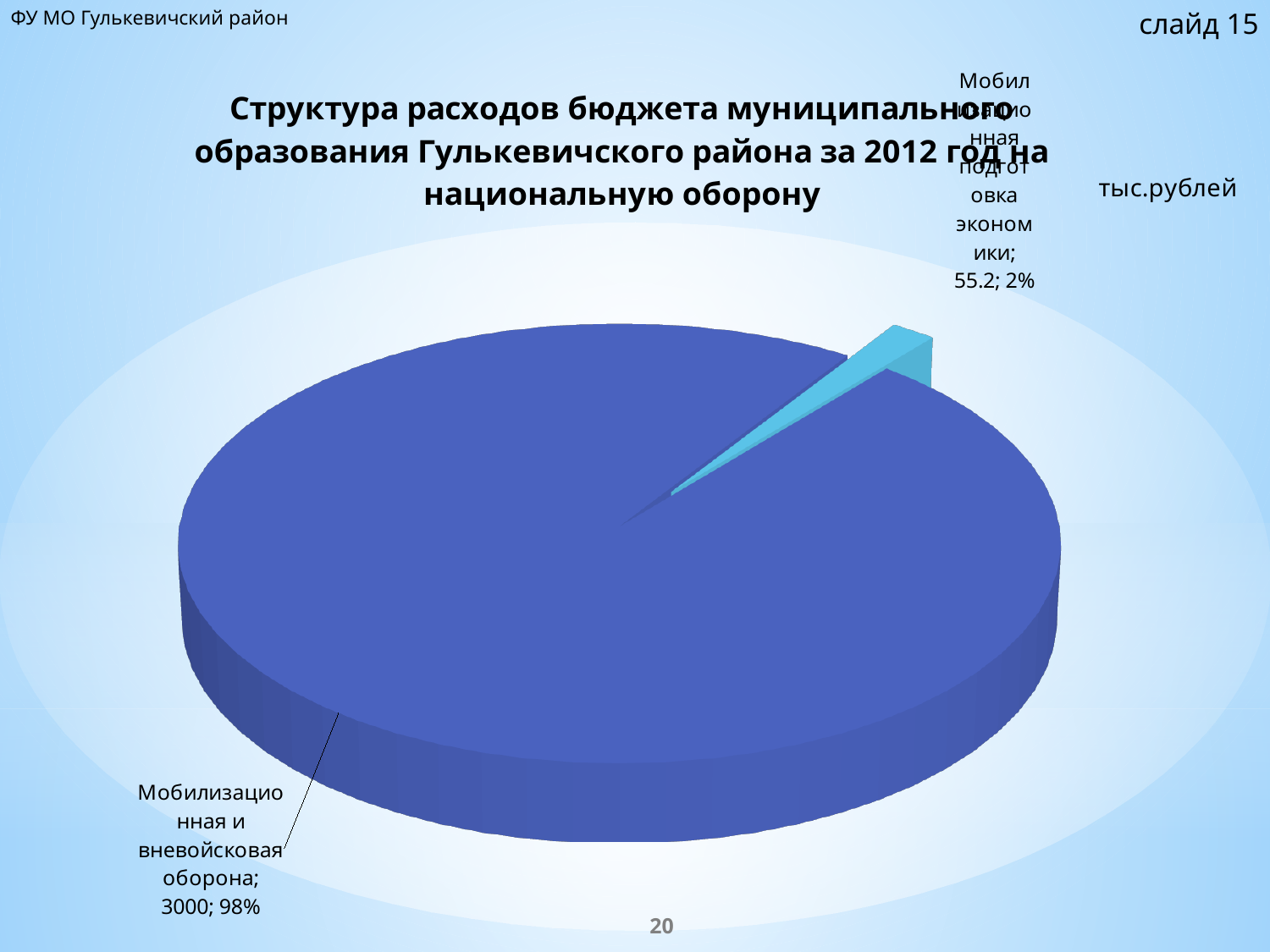
What is the value for "Мобилизационная и вневойсковая оборона"? 3000 What kind of chart is shown on the slide? pie chart Which is larger: the value for "Мобилизационная и вневойсковая оборона" or for "Мобилизационная подготовка экономики"? Мобилизационная и вневойсковая оборона In what units are the values on the chart expressed, according to the slide? тыс.рублей Which category has the smallest slice of the pie? Мобилизационная подготовка экономики What is the difference between the values for "Мобилизационная и вневойсковая оборона" and "Мобилизационная подготовка экономики"? 2944.8 What share of the pie does "Мобилизационная подготовка экономики" represent? 2% Which category has the largest slice of the pie? Мобилизационная и вневойсковая оборона What is the total of the two values shown in the pie chart? 3055.2 What share of the pie does "Мобилизационная и вневойсковая оборона" represent? 98% What is the value for "Мобилизационная подготовка экономики"? 55.2 How many slices does the pie chart have? 2